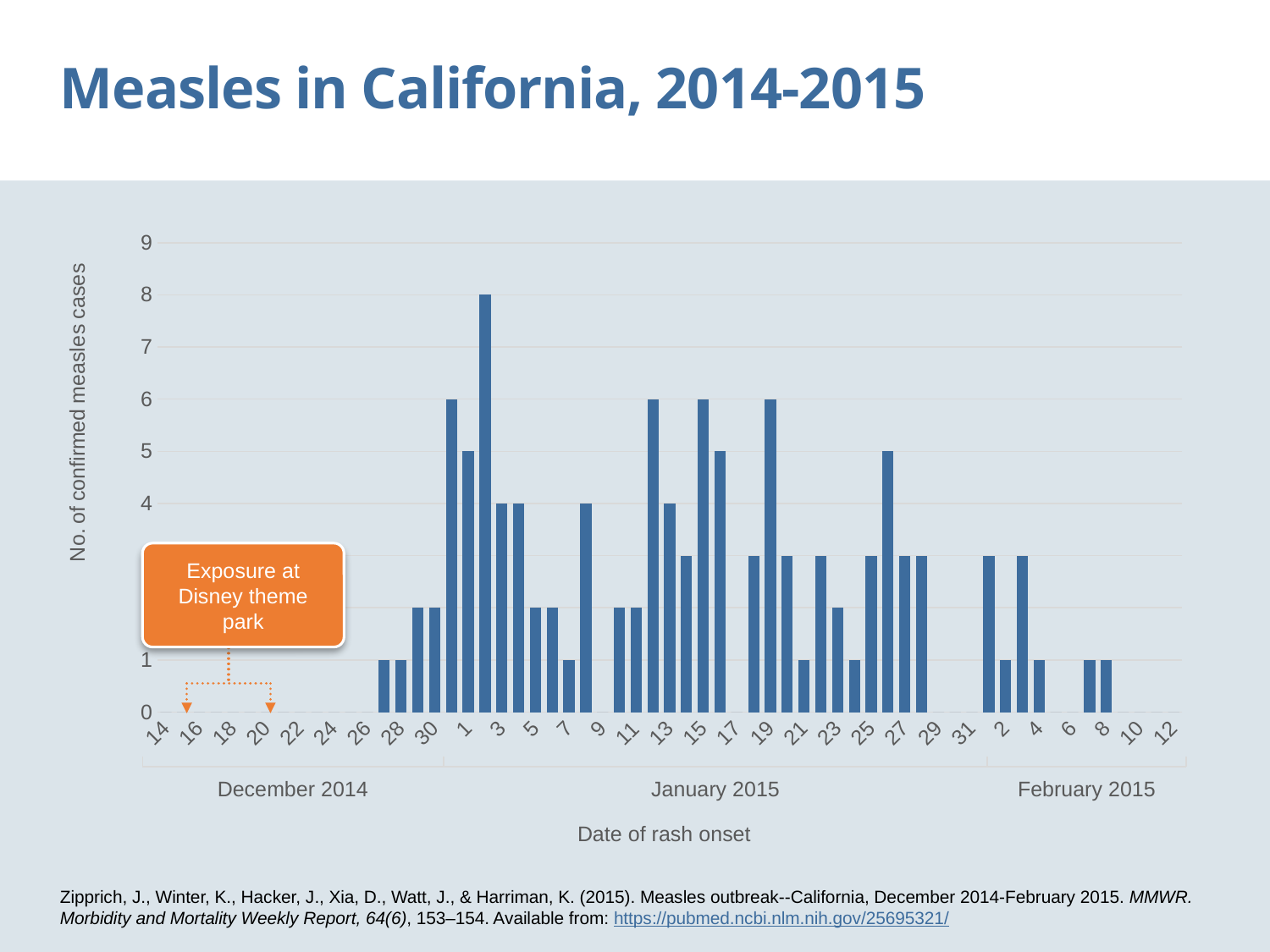
What is the highest number of confirmed measles cases recorded on a single day? 8 Which month has the higher peak daily case count, December 2014 or January 2015? January 2015 How many confirmed measles cases are shown for January 2, 2015? 8 What is the label of the y axis? No. of confirmed measles cases In which month does the tallest bar occur? January 2015 How many months are labeled along the x axis? 3 What is the difference between the highest daily count in January 2015 and the highest daily count in December 2014? 2 Do the daily case counts generally rise or fall from late January into February 2015? fall What kind of chart is shown on the slide? bar chart Is the tallest bar greater or less than 7? greater What does the orange callout box on the chart say? Exposure at Disney theme park How many days have exactly 6 confirmed cases? 4